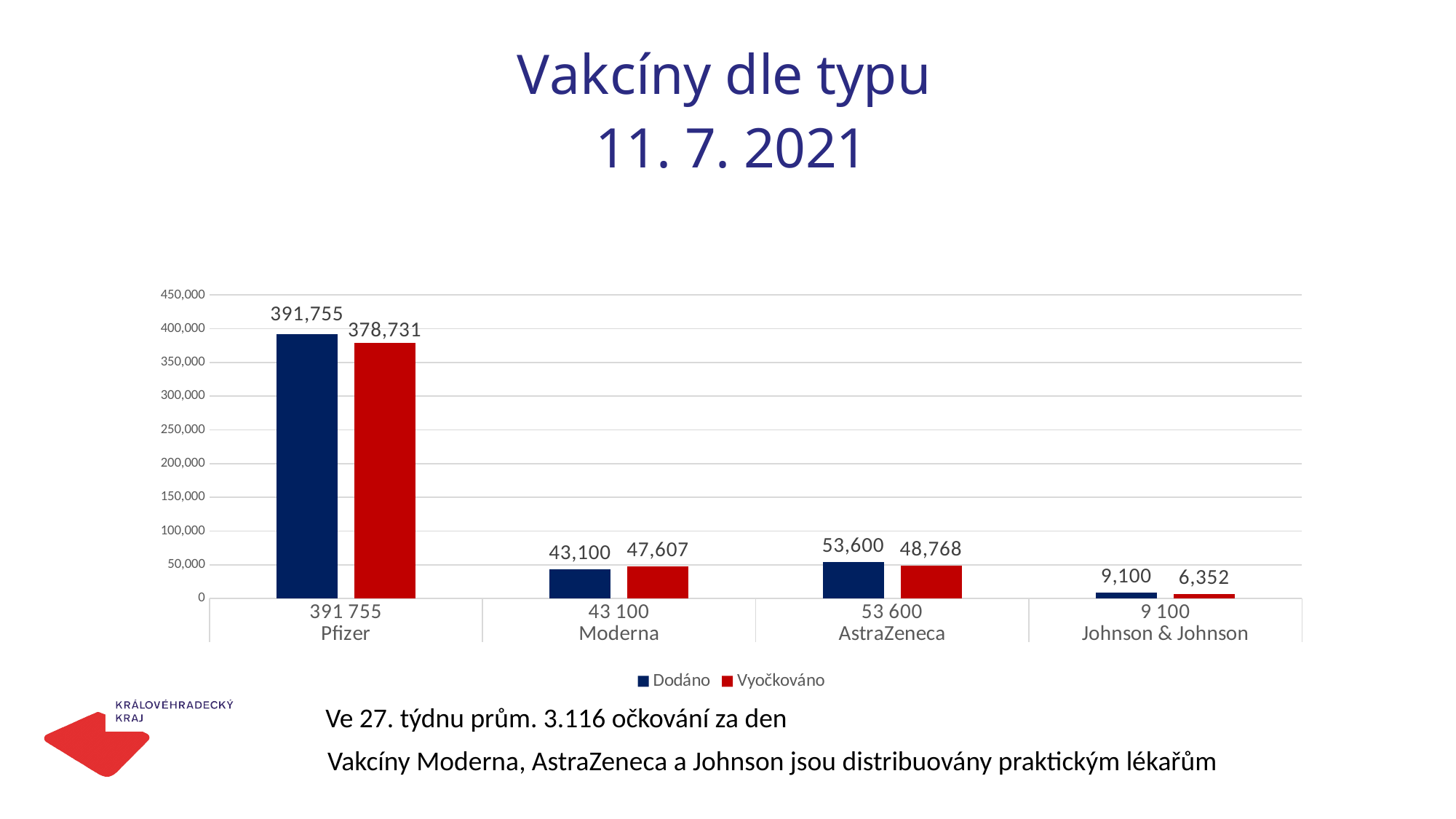
What is the Vyočkováno value for Moderna? 47,607 What is the Dodáno value for Pfizer? 391,755 How many series does the legend list? 2 Which vaccine has the highest Dodáno value? Pfizer What is the Vyočkováno value for Johnson & Johnson? 6,352 What kind of chart is shown on the slide? Bar chart What is the difference between the Dodáno and Vyočkováno values for Pfizer? 13,024 What is the difference between the Dodáno values for AstraZeneca and Moderna? 10,500 Which vaccine has the lowest Vyočkováno value? Johnson & Johnson What is the Dodáno value for AstraZeneca? 53,600 How many vaccine types are shown on the x axis? 4 For Moderna, which is larger: Dodáno or Vyočkováno? Vyočkováno